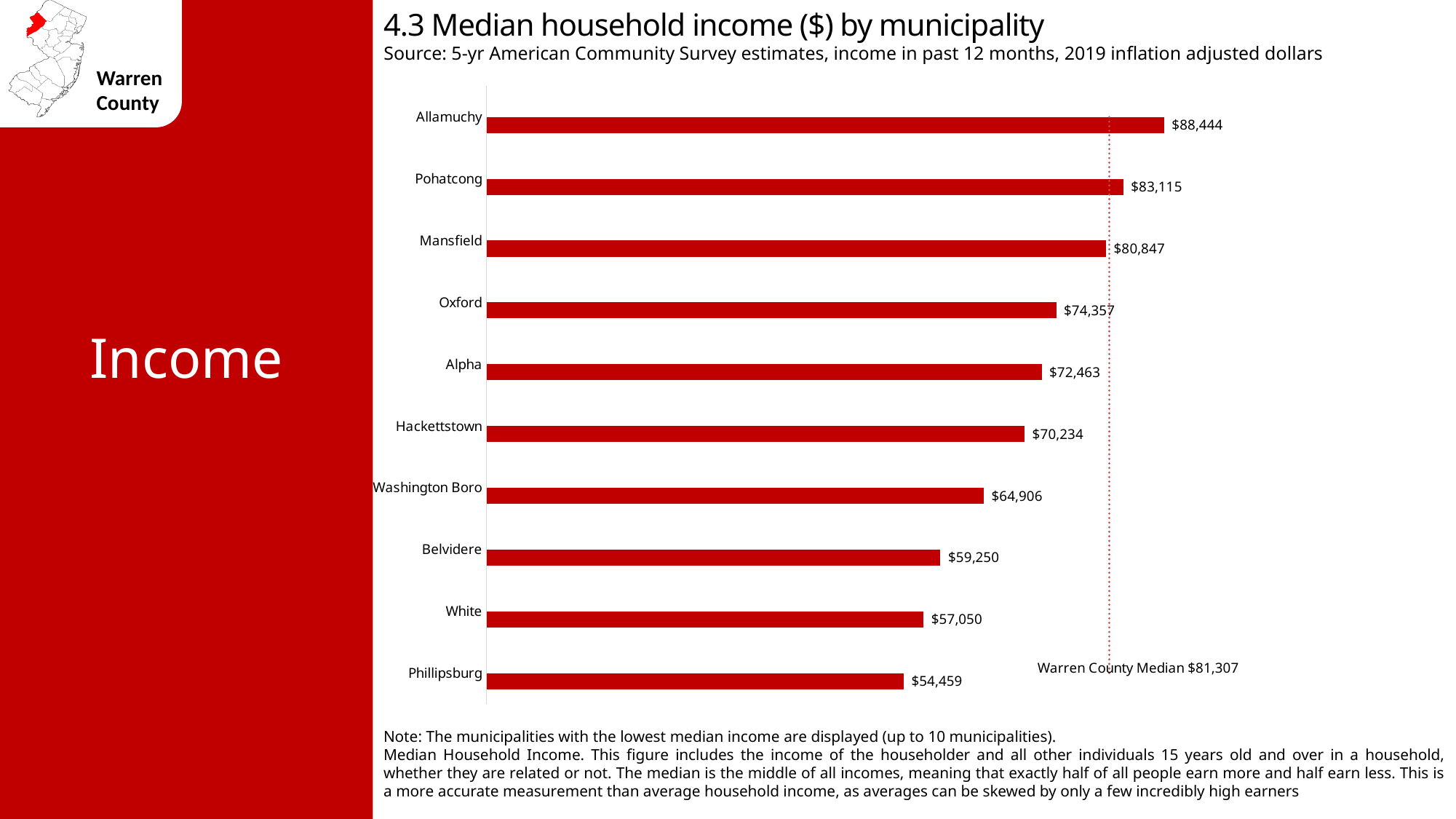
What is the median household income for Allamuchy? $88,444 What kind of chart is used to show median household income by municipality? Bar chart Which has a higher median household income, Oxford or Alpha? Oxford What is the Warren County median household income shown by the dotted line? $81,307 Which municipality has the highest median household income on the chart? Allamuchy What is the median household income for Phillipsburg? $54,459 What is the difference between the median household income of Belvidere and White? $2,200 Which municipality has the lowest median household income on the chart? Phillipsburg What is the median household income for Hackettstown? $70,234 How many municipalities have a median household income above the Warren County median of $81,307? 2 What is the difference between the median household income of Allamuchy and Phillipsburg? $33,985 How many municipalities are shown on the chart? 10